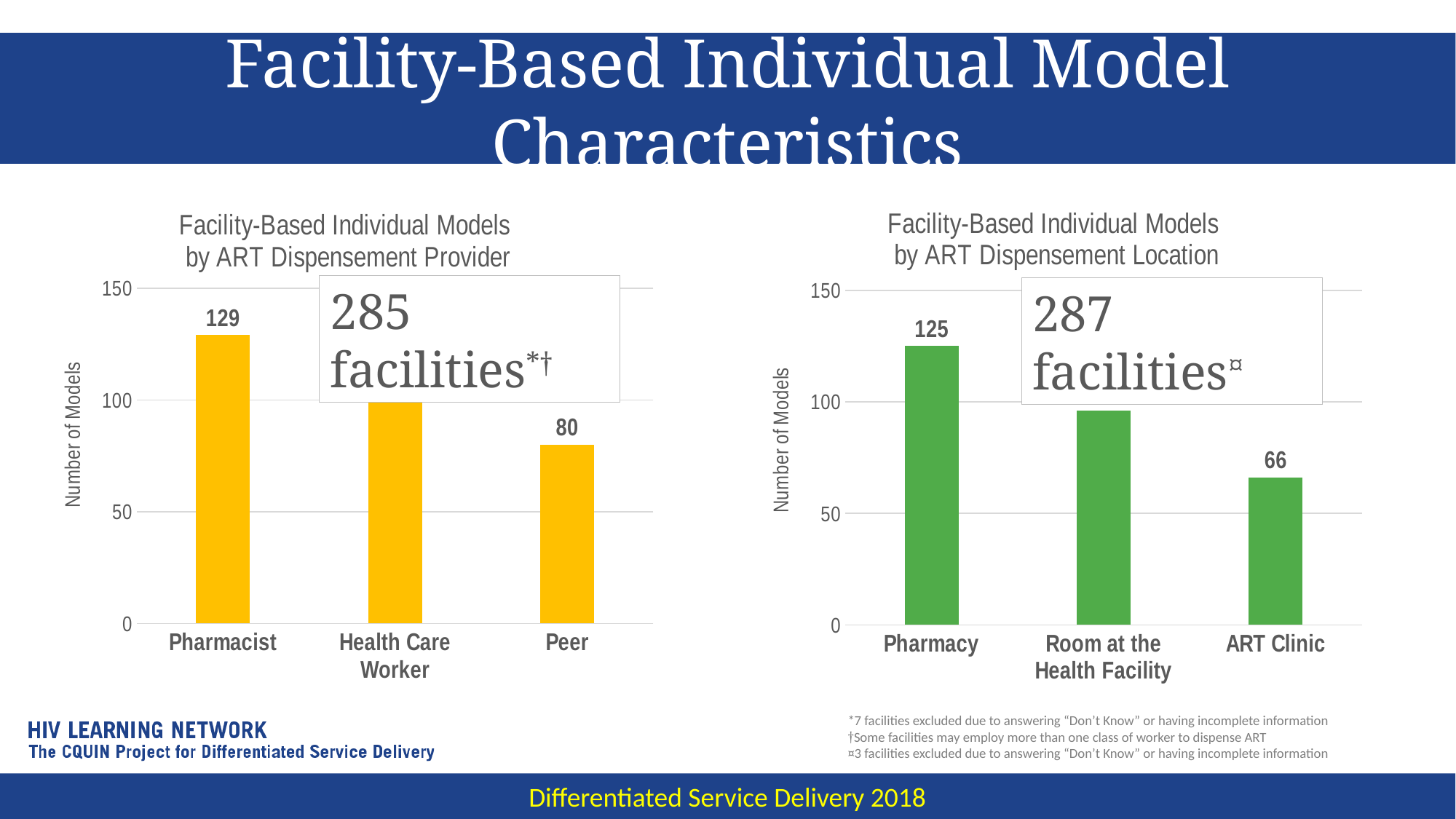
What type of chart is 'Facility-Based Individual Models by ART Dispensement Provider'? Bar chart In the chart 'Facility-Based Individual Models by ART Dispensement Location', what is the value for ART Clinic? 66 In the chart 'Facility-Based Individual Models by ART Dispensement Location', which category has the lowest value? ART Clinic In the chart 'Facility-Based Individual Models by ART Dispensement Location', what is the value for Pharmacy? 125 In the chart 'Facility-Based Individual Models by ART Dispensement Provider', what is the value for Peer? 80 In the chart 'Facility-Based Individual Models by ART Dispensement Provider', is the value for Health Care Worker greater or less than 50? greater In the chart 'Facility-Based Individual Models by ART Dispensement Location', is the value for Room at the Health Facility greater or less than 50? greater In the chart 'Facility-Based Individual Models by ART Dispensement Provider', what is the difference between the values for Pharmacist and Peer? 49 In the chart 'Facility-Based Individual Models by ART Dispensement Provider', what is the value for Pharmacist? 129 In the chart 'Facility-Based Individual Models by ART Dispensement Provider', which category has the highest value? Pharmacist How many categories are shown in the chart 'Facility-Based Individual Models by ART Dispensement Location'? 3 In the chart 'Facility-Based Individual Models by ART Dispensement Location', what is the difference between the values for Pharmacy and ART Clinic? 59